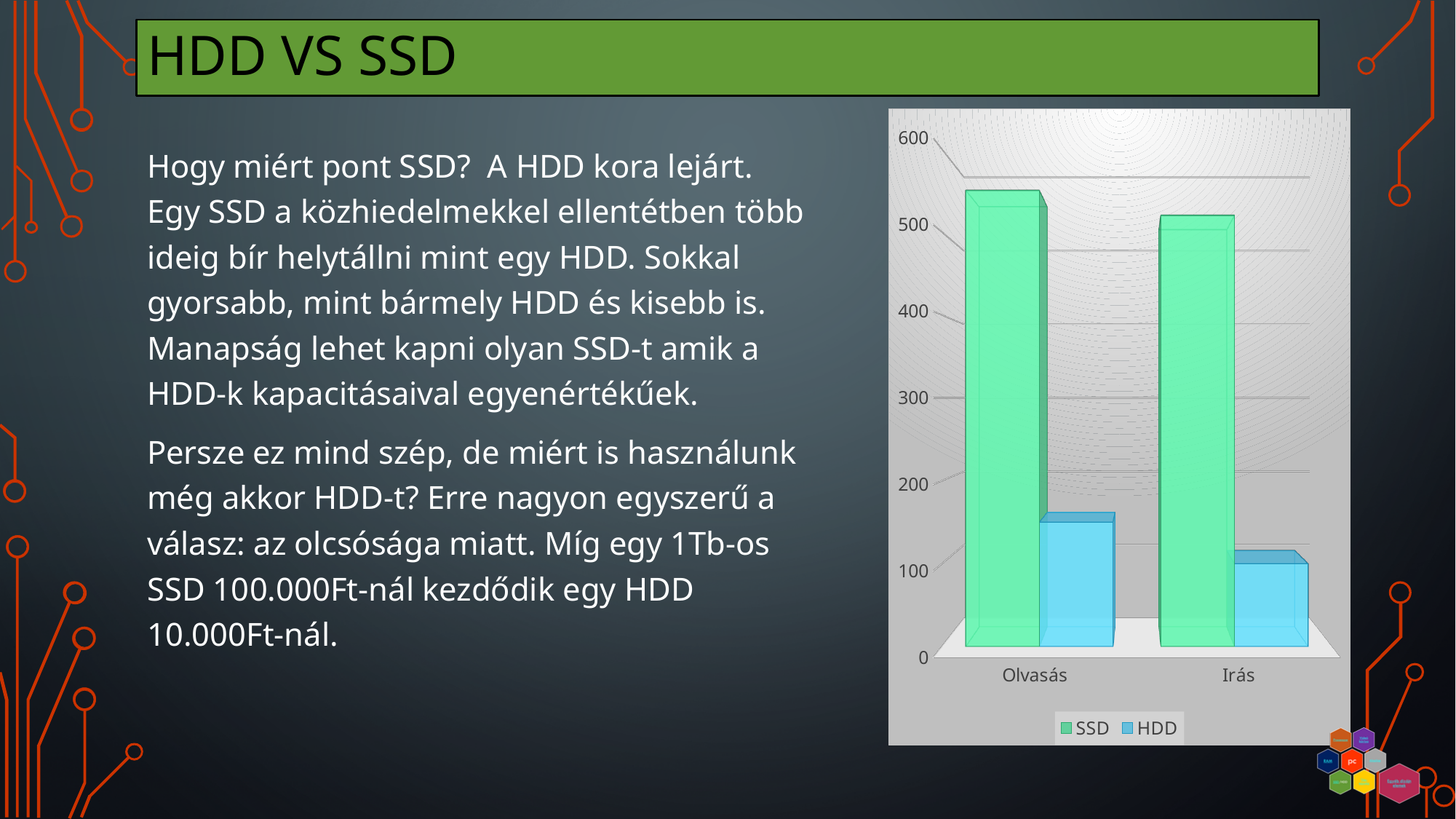
For Olvasás, which series has the larger value, SSD or HDD? SSD What colour are the SSD bars in the chart? green Is the SSD value for Irás greater or less than 400? greater Which category has the highest SSD value? Olvasás What kind of chart is shown on the slide? bar chart How many series does the chart legend list? 2 How many categories are shown on the x axis of the chart? 2 Which category has the lowest HDD value? Irás Is the HDD value for Irás greater or less than 200? less Which series are listed in the chart legend? SSD and HDD Is the SSD value for Olvasás greater or less than 500? greater